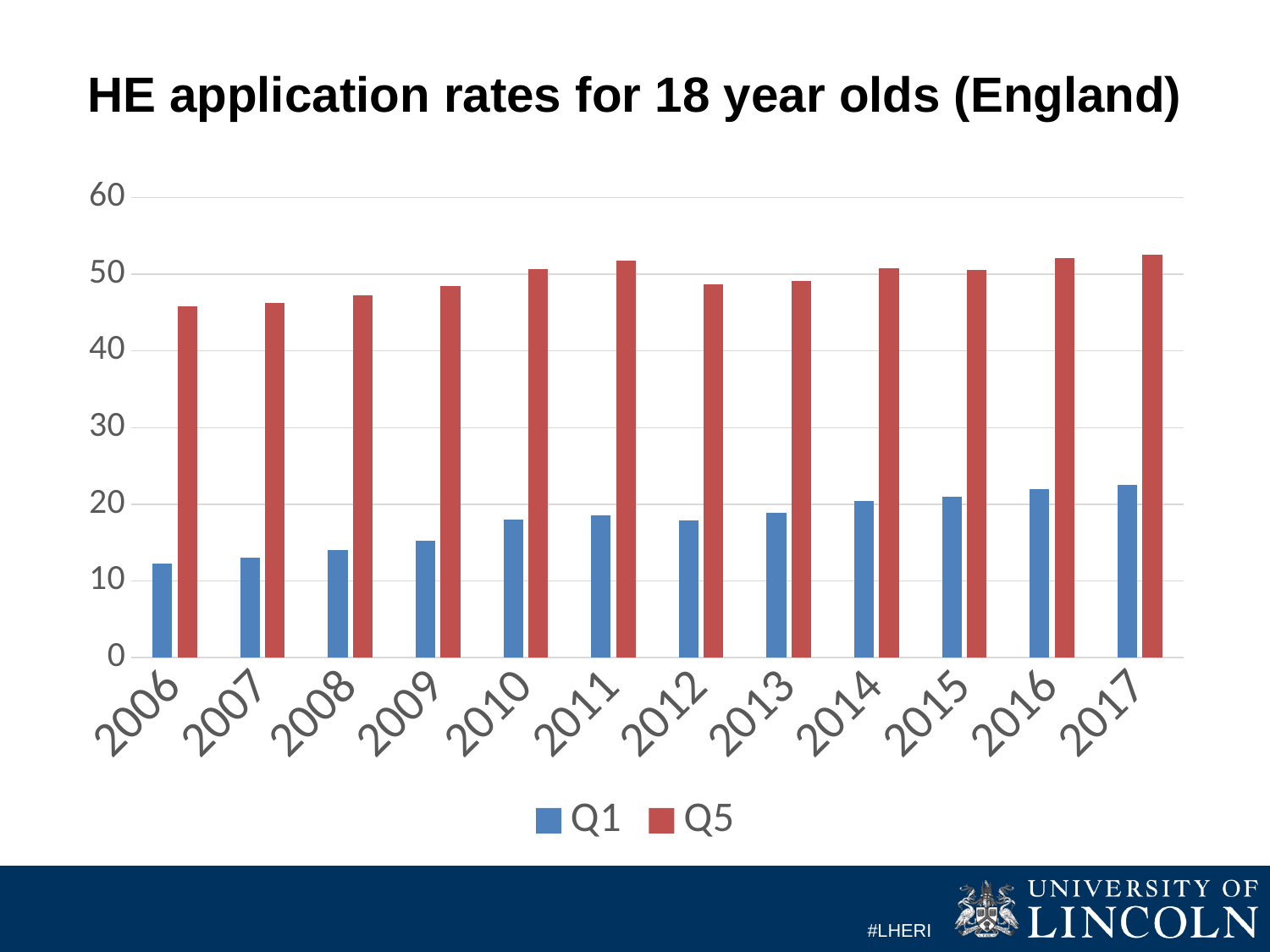
Is the Q5 value for 2011 greater or less than 50? greater How many years are shown on the x axis? 12 Is the Q5 value for 2006 greater or less than 50? less Do the Q1 values generally rise or fall from 2006 to 2017? Rise What kind of chart is shown on the slide? Bar chart Which series has the larger value in 2010, Q1 or Q5? Q5 Which year has the lowest Q1 value? 2006 Is the Q1 value for 2006 greater or less than 10? greater How many series does the legend list? 2 What is the title of the chart? HE application rates for 18 year olds (England) Which colour represents the Q5 series? Red